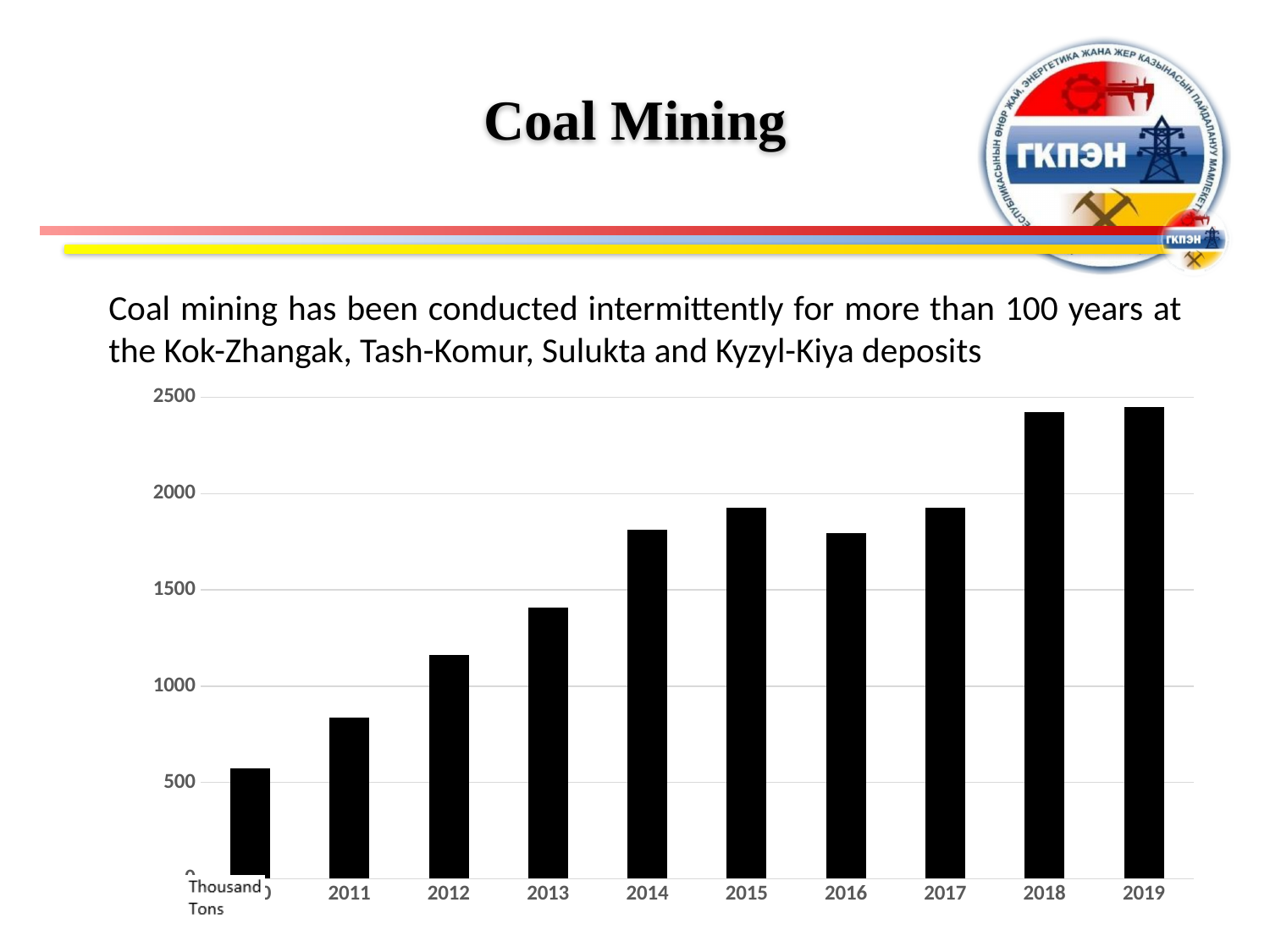
What kind of chart is shown on the slide? bar chart Is the value for 2015 greater or less than 2000? less Is the value for 2011 greater or less than 1000? less Is the value for 2018 greater or less than 2000? greater What unit is shown for the values on the chart's vertical axis? Thousand Tons Which year has the larger value, 2016 or 2018? 2018 Which year has the larger value, 2012 or 2013? 2013 Do the values generally rise or fall from 2011 to 2019? rise How many bars (years) are plotted in the chart? 10